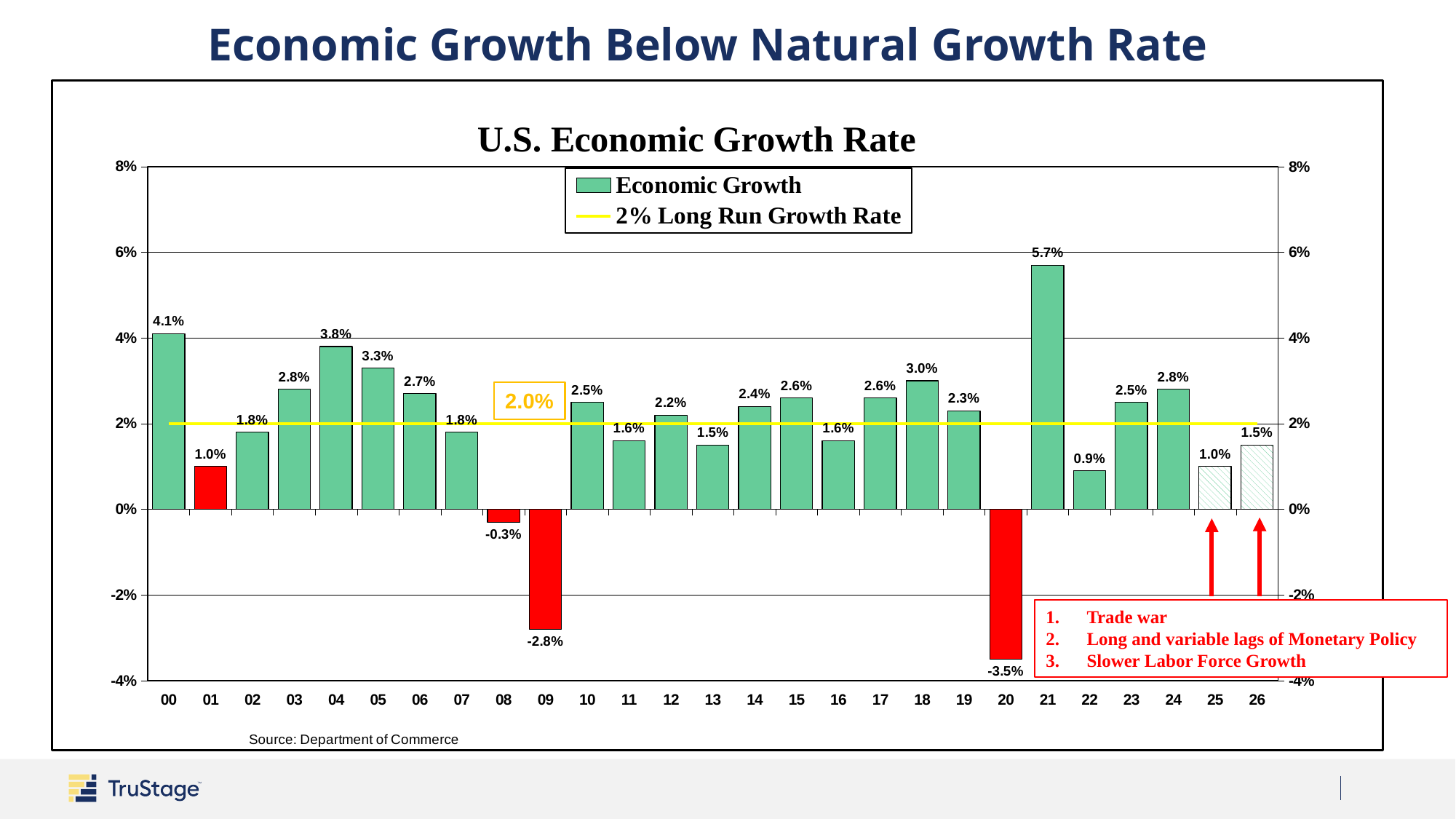
What is the economic growth rate shown for 2009 (bar labelled 09)? -2.8% How many series does the legend list? 2 Which year has the lowest economic growth rate on the chart? 20 How many years (bars) are shown on the x axis of the chart? 27 What is the difference between the growth rate in 2021 (5.7%) and in 2022 (0.9%)? 4.8 percentage points Which year has the highest economic growth rate on the chart? 21 Which year has a higher growth rate, 2004 or 2005? 04 What is the economic growth rate shown for 2025 (bar labelled 25)? 1.0% What kind of chart is used to show the U.S. Economic Growth Rate? Bar chart What is the source cited below the chart? Department of Commerce What value does the yellow horizontal line represent, according to the legend? 2% Long Run Growth Rate What is the U.S. economic growth rate shown for 2021 (bar labelled 21)? 5.7%